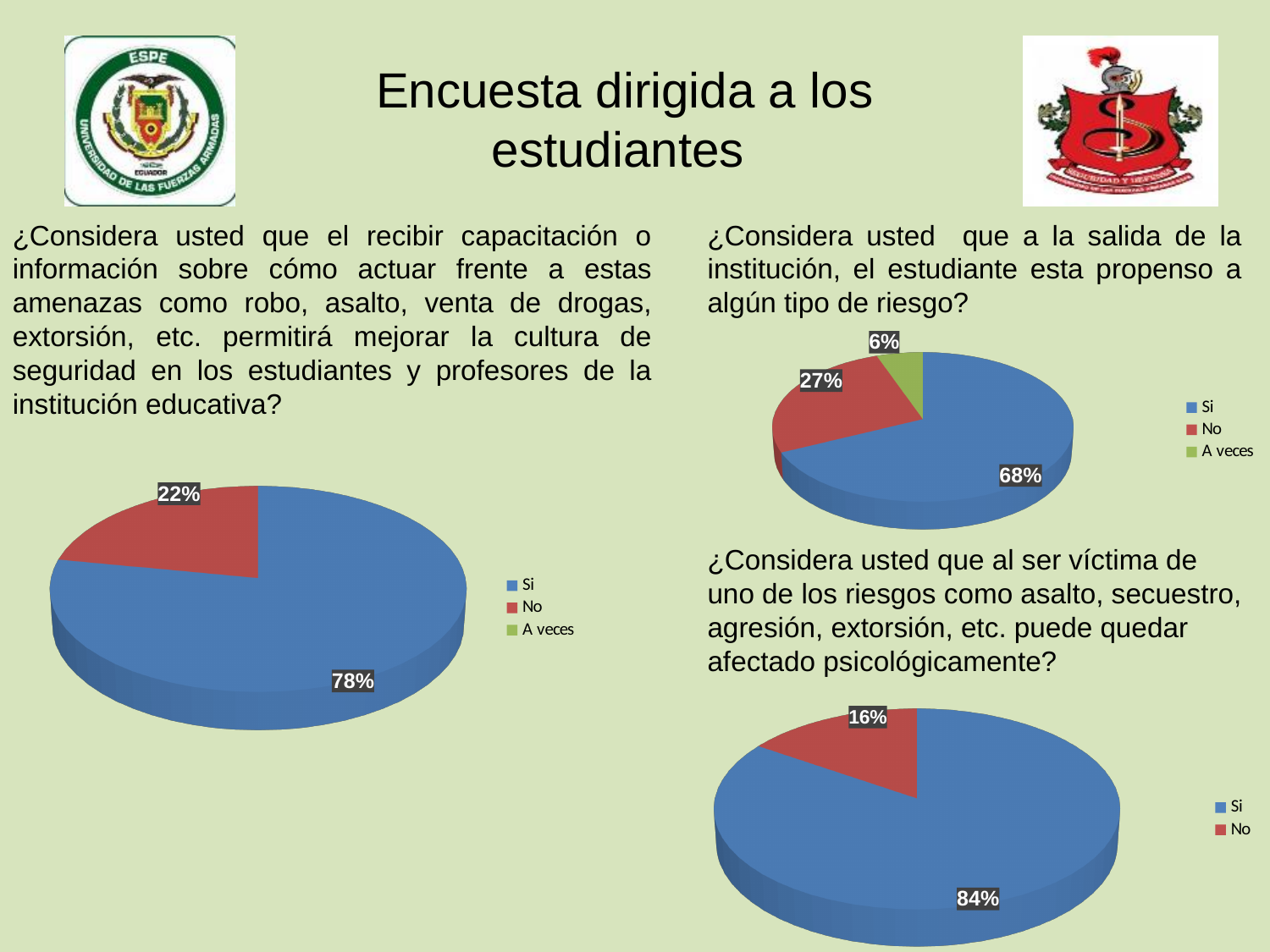
In the pie chart at the bottom right of the slide, what share is labelled for "Si"? 84% In the pie chart at the top right of the slide, which category has the largest slice? Si In the pie chart at the top right of the slide, which category has the smallest slice? A veces In the pie chart on the left of the slide, what share is labelled for "No"? 22% What kind of chart is used for the three charts on the slide? Pie chart In the pie chart at the bottom right of the slide, how many entries does the legend list? 2 In the pie chart at the top right of the slide, what share is labelled for "No"? 27% In the pie chart at the top right of the slide, what share is labelled for "A veces"? 6% In the pie chart on the left of the slide, how many entries does the legend list? 3 In the pie chart at the top right of the slide, what is the difference between the "Si" and "No" shares? 41% In the pie chart on the left of the slide, what share is labelled for "Si"? 78% In the pie chart at the bottom right of the slide, what share is labelled for "No"? 16%